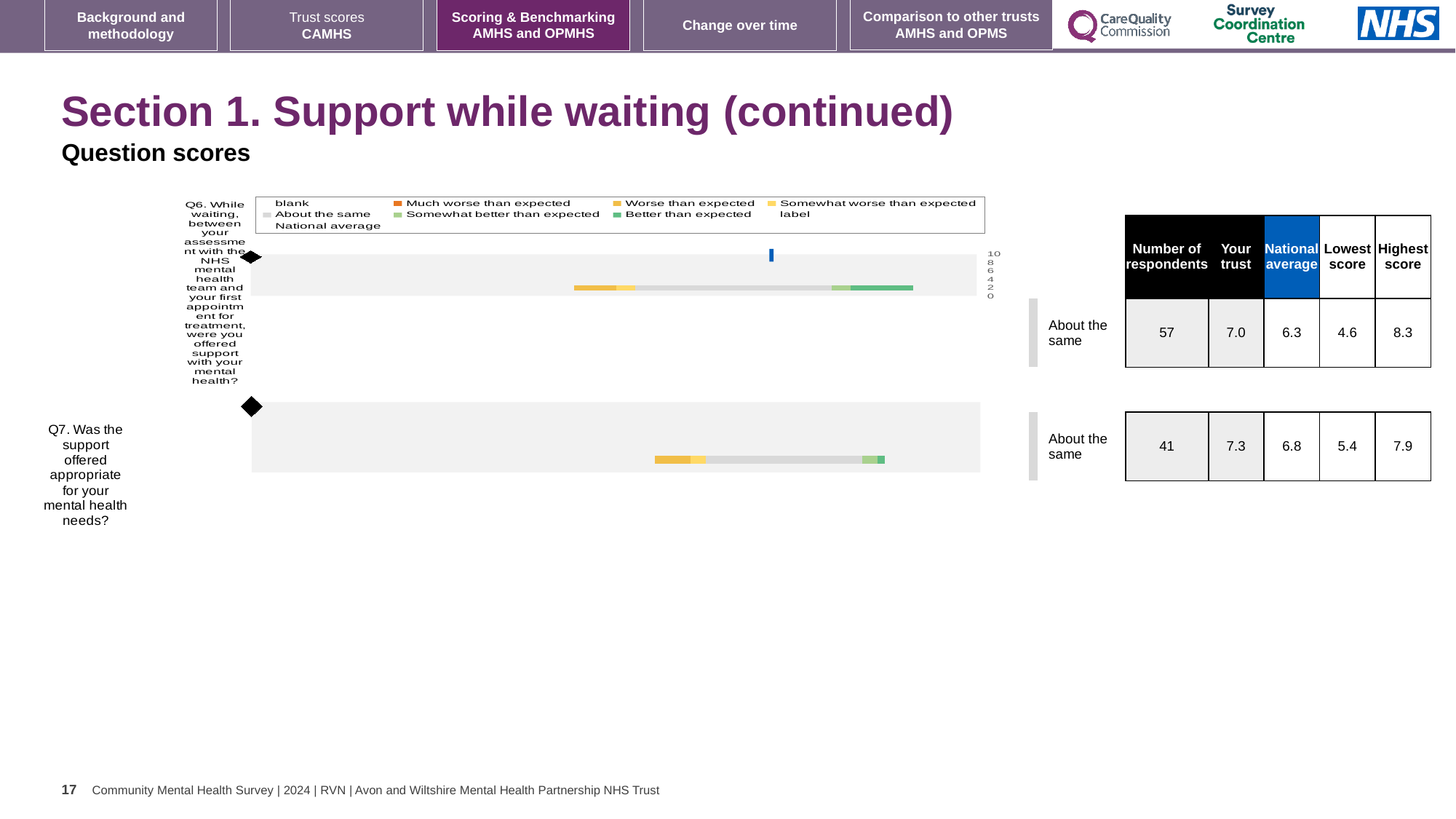
How many respondents are listed for Q6? 57 How many survey questions are plotted as bars in the chart? 2 By how much does the 'Your trust' score for Q7 exceed the national average for Q7? 0.5 What is the lowest score listed for Q7? 5.4 What benchmark category is shown next to both Q6 and Q7 bars? About the same What kind of chart is shown on the slide? bar chart Which question has more respondents, Q6 or Q7? Q6 What is the national average score for Q7 in the table beside the chart? 6.8 Which question has the higher 'Your trust' score, Q6 or Q7? Q7 What colour represents 'Better than expected' in the chart legend? green What is the 'Your trust' score for Q6 in the table beside the chart? 7.0 What is the difference between the highest score and the lowest score for Q6? 3.7